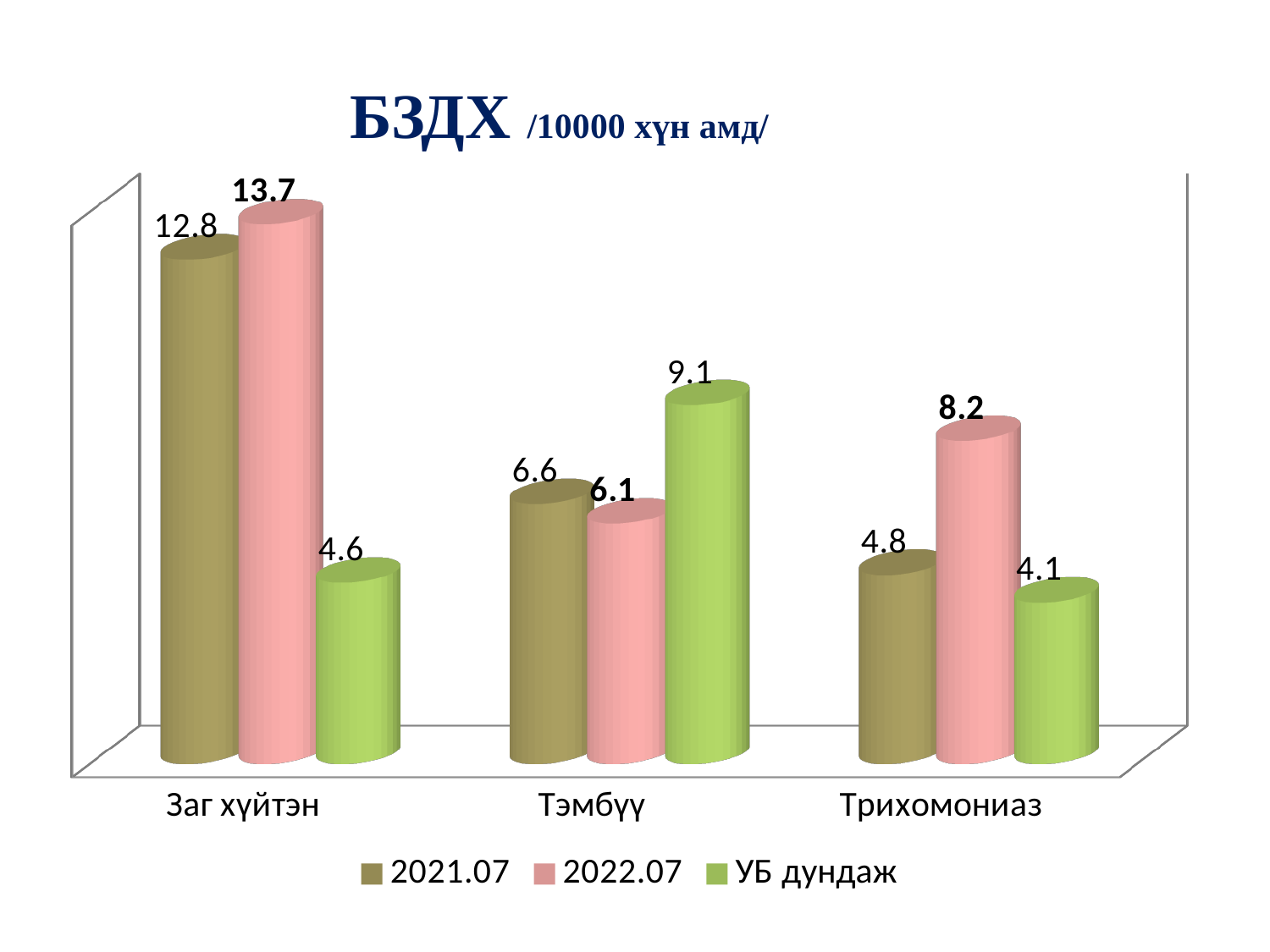
How many categories are shown on the x axis? 3 What is the title of the chart? БЗДХ /10000 хүн амд/ What is the difference between the 2022.07 and 2021.07 values for Трихомониаз? 3.4 What is the difference between the 2022.07 and 2021.07 values for Заг хүйтэн? 0.9 For Тэмбүү, which is larger: the 2021.07 value or the УБ дундаж value? УБ дундаж Which category has the highest 2021.07 value? Заг хүйтэн What kind of chart is shown on the slide? Bar chart Which category has the lowest УБ дундаж value? Трихомониаз How many series does the legend list? 3 What is the УБ дундаж value for Тэмбүү? 9.1 What is the value for Заг хүйтэн in the 2022.07 series? 13.7 What is the 2021.07 value for Трихомониаз? 4.8